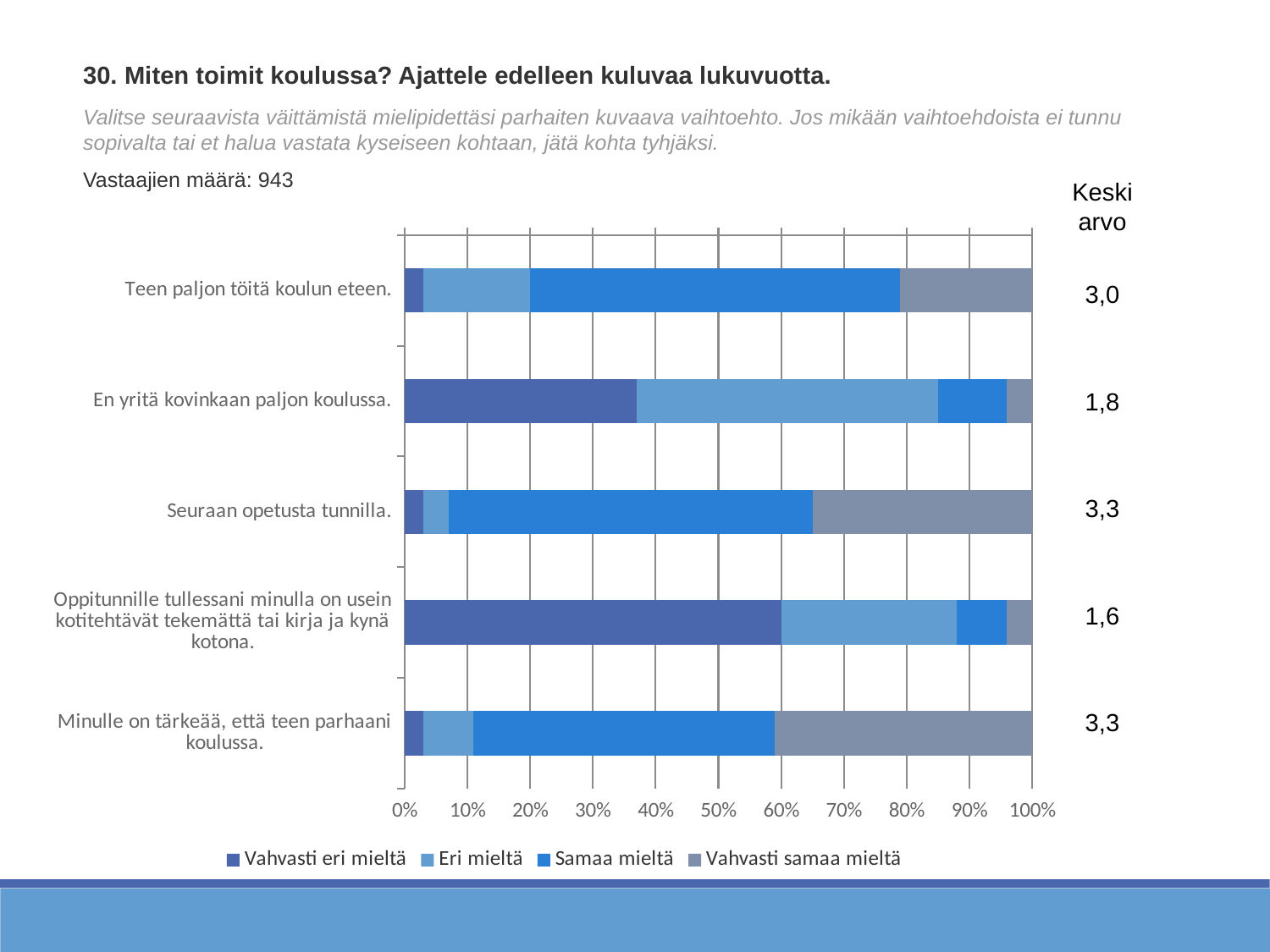
What are the four legend entries of the chart? Vahvasti eri mieltä, Eri mieltä, Samaa mieltä, Vahvasti samaa mieltä What is the Keskiarvo value for 'Oppitunnille tullessani minulla on usein kotitehtävät tekemättä tai kirja ja kynä kotona.'? 1,6 Is the 'Vahvasti eri mieltä' share for 'Teen paljon töitä koulun eteen.' greater or less than 10%? less What is the Keskiarvo value for 'Teen paljon töitä koulun eteen.'? 3,0 Which has the larger Keskiarvo value: 'Seuraan opetusta tunnilla.' or 'En yritä kovinkaan paljon koulussa.'? Seuraan opetusta tunnilla. Is the 'Vahvasti eri mieltä' share for 'Oppitunnille tullessani minulla on usein kotitehtävät tekemättä tai kirja ja kynä kotona.' greater or less than 50%? greater Which statement has the lowest Keskiarvo value? Oppitunnille tullessani minulla on usein kotitehtävät tekemättä tai kirja ja kynä kotona. What is the Keskiarvo value for 'En yritä kovinkaan paljon koulussa.'? 1,8 How many statements (categories) are plotted in the chart? 5 What kind of chart is shown on the slide? Stacked bar chart What is the difference between the Keskiarvo values for 'Teen paljon töitä koulun eteen.' and 'En yritä kovinkaan paljon koulussa.'? 1,2 How many series does the legend list? 4